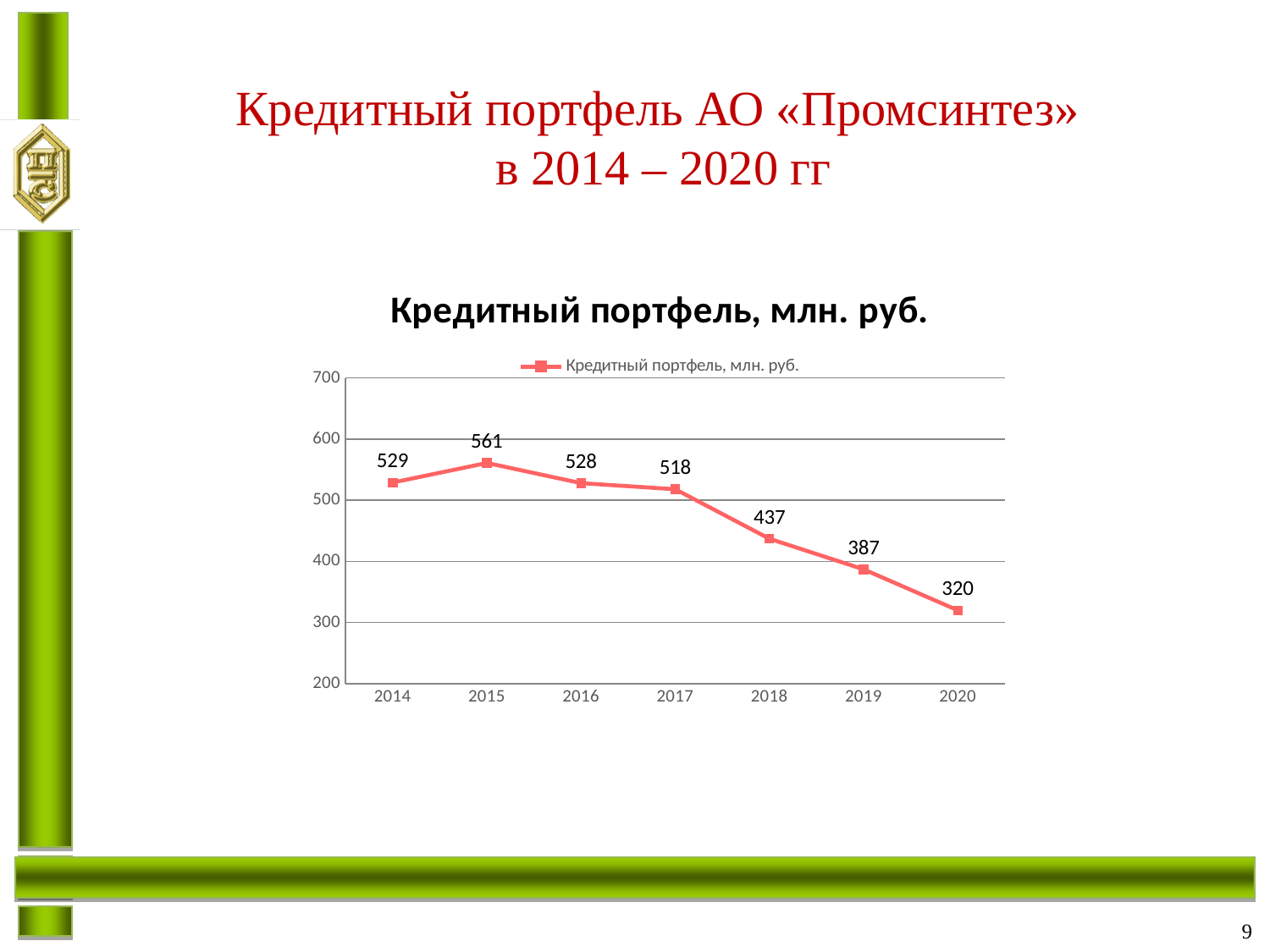
What is the value of the credit portfolio in 2018? 437 Which year has a larger credit portfolio, 2016 or 2019? 2016 What is the value of the credit portfolio in 2020? 320 What is the difference between the credit portfolio in 2017 and in 2018? 81 In which year is the credit portfolio lowest? 2020 What is the difference between the credit portfolio in 2015 and in 2020? 241 What kind of chart is shown on the slide? line chart Is the value for 2019 greater or less than 400? less What is the value of the credit portfolio in 2014? 529 What is the overall trend of the credit portfolio from 2015 to 2020? falling In which year is the credit portfolio highest? 2015 How many years are plotted on the chart? 7